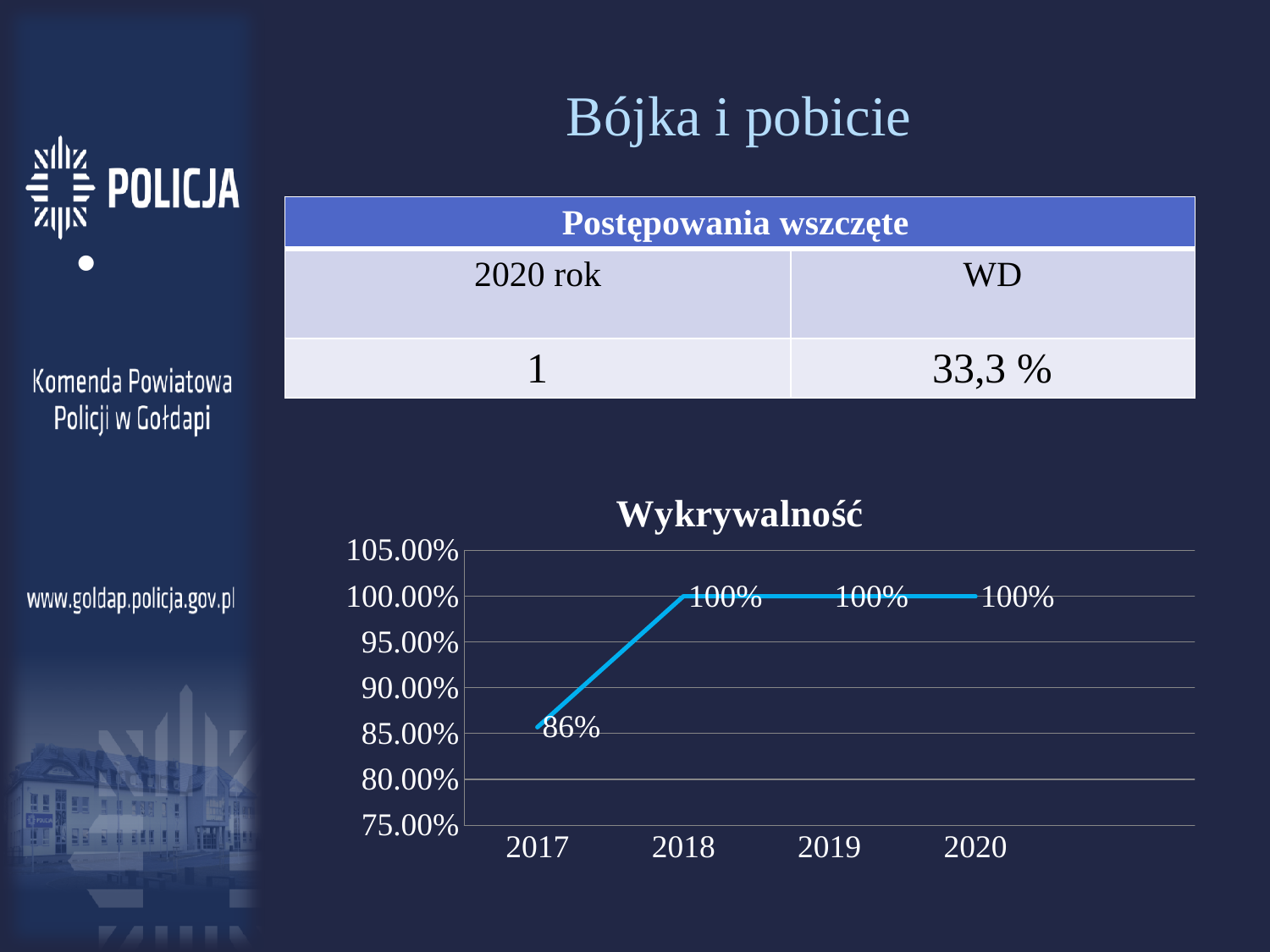
What is the title of the chart? Wykrywalność What is the value for 2020 in the Wykrywalność chart? 100% Which is larger in the Wykrywalność chart, the value for 2017 or the value for 2019? 2019 Does the value in the Wykrywalność chart rise or fall from 2017 to 2018? rise What is the difference between the values for 2018 and 2017 in the Wykrywalność chart? 14% What is the value for 2017 in the Wykrywalność chart? 86% Which year has the lowest value in the Wykrywalność chart? 2017 What is the value for 2018 in the Wykrywalność chart? 100% How many years are plotted on the x axis of the Wykrywalność chart? 4 Is the value for 2017 in the Wykrywalność chart greater or less than 90.00%? less What type of chart is shown on the slide? line chart What is the lowest value shown on the y axis of the Wykrywalność chart? 75.00%